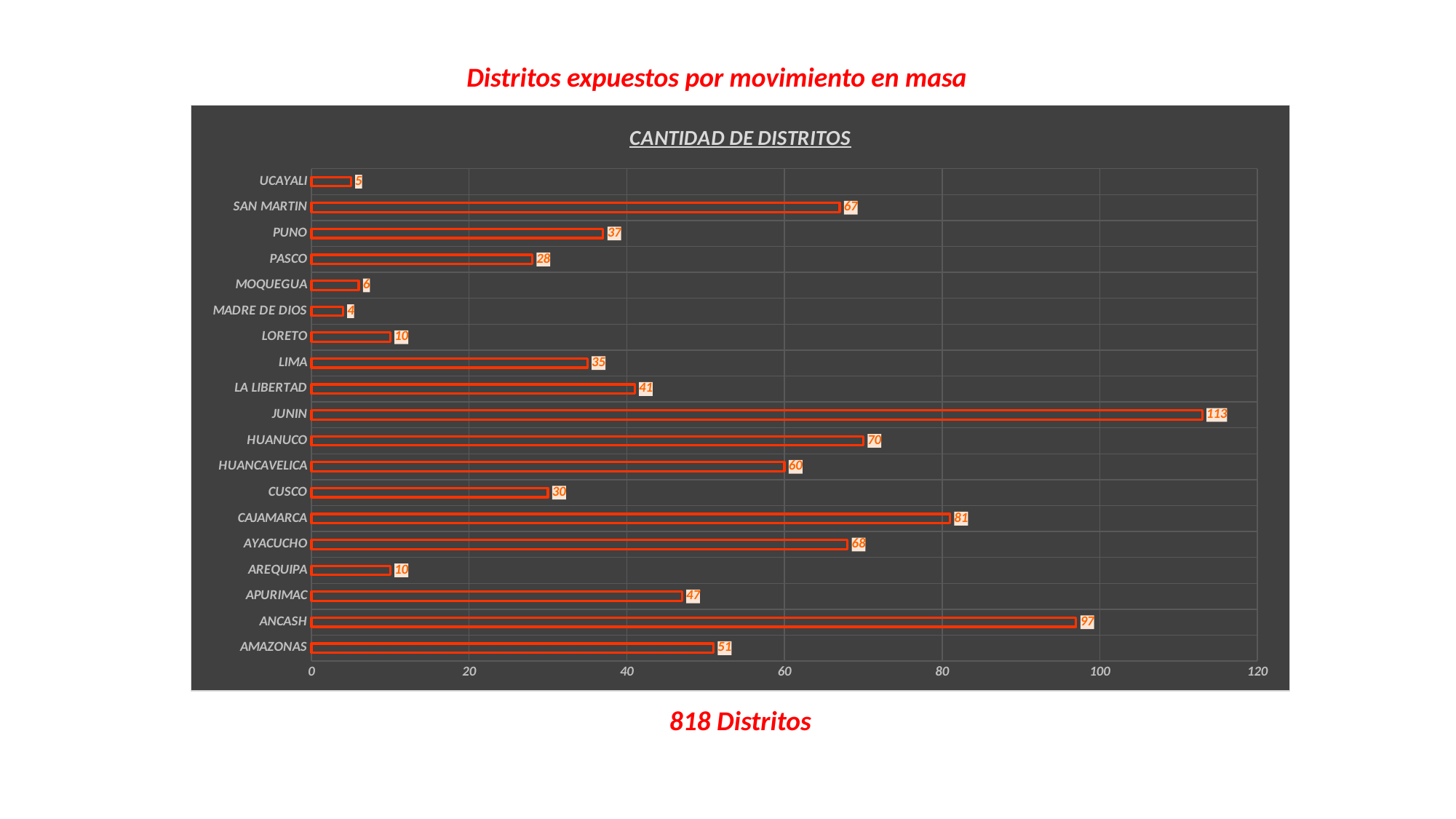
What is the highest value shown on the x axis? 120 What is the title of the chart? CANTIDAD DE DISTRITOS What is the value for MADRE DE DIOS? 4 Which category has the highest value? JUNIN What kind of chart is shown on the slide? bar chart What is the value for CAJAMARCA? 81 How many categories are shown in the chart? 19 Which is larger, the value for HUANUCO or the value for AYACUCHO? HUANUCO What is the value for JUNIN? 113 Is the value for SAN MARTIN greater or less than 60? greater Which category has the lowest value? MADRE DE DIOS What is the difference between the values for ANCASH and AMAZONAS? 46